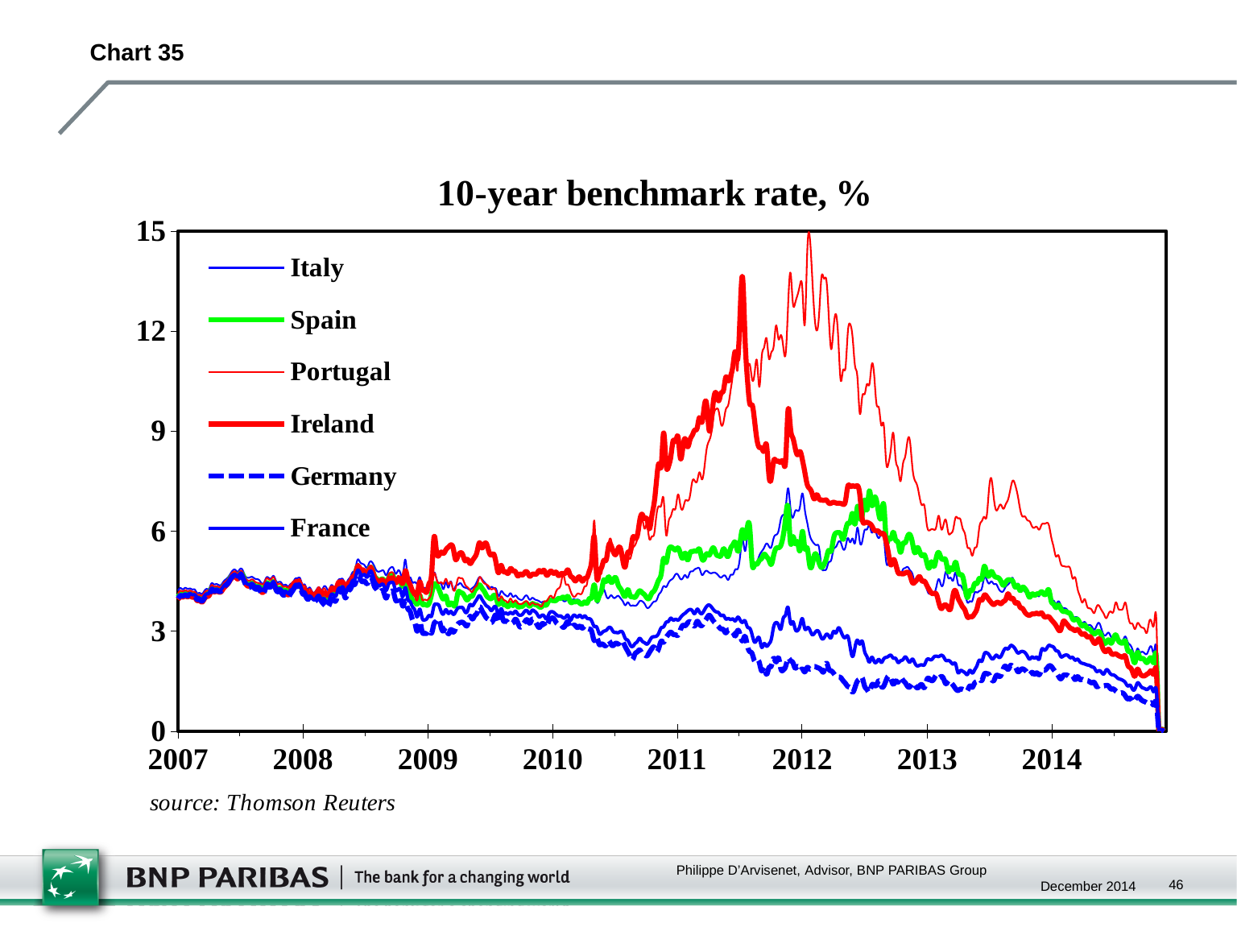
Which series is drawn with a dashed line? Germany Is the peak value for Ireland in 2011 greater or less than 12? greater Is the peak value for Spain in 2012 greater or less than 9? less Is the peak value for Portugal greater or less than 12? greater How many series does the legend list? 6 What kind of chart is shown on the slide? line chart Which series reaches the highest peak on the chart? Portugal What is the title of the chart? 10-year benchmark rate, % Which series is the lowest during 2013? Germany During 2013, is the value for Portugal higher or lower than the value for Spain? higher Does the value for Portugal rise or fall from 2012 to 2014? fall